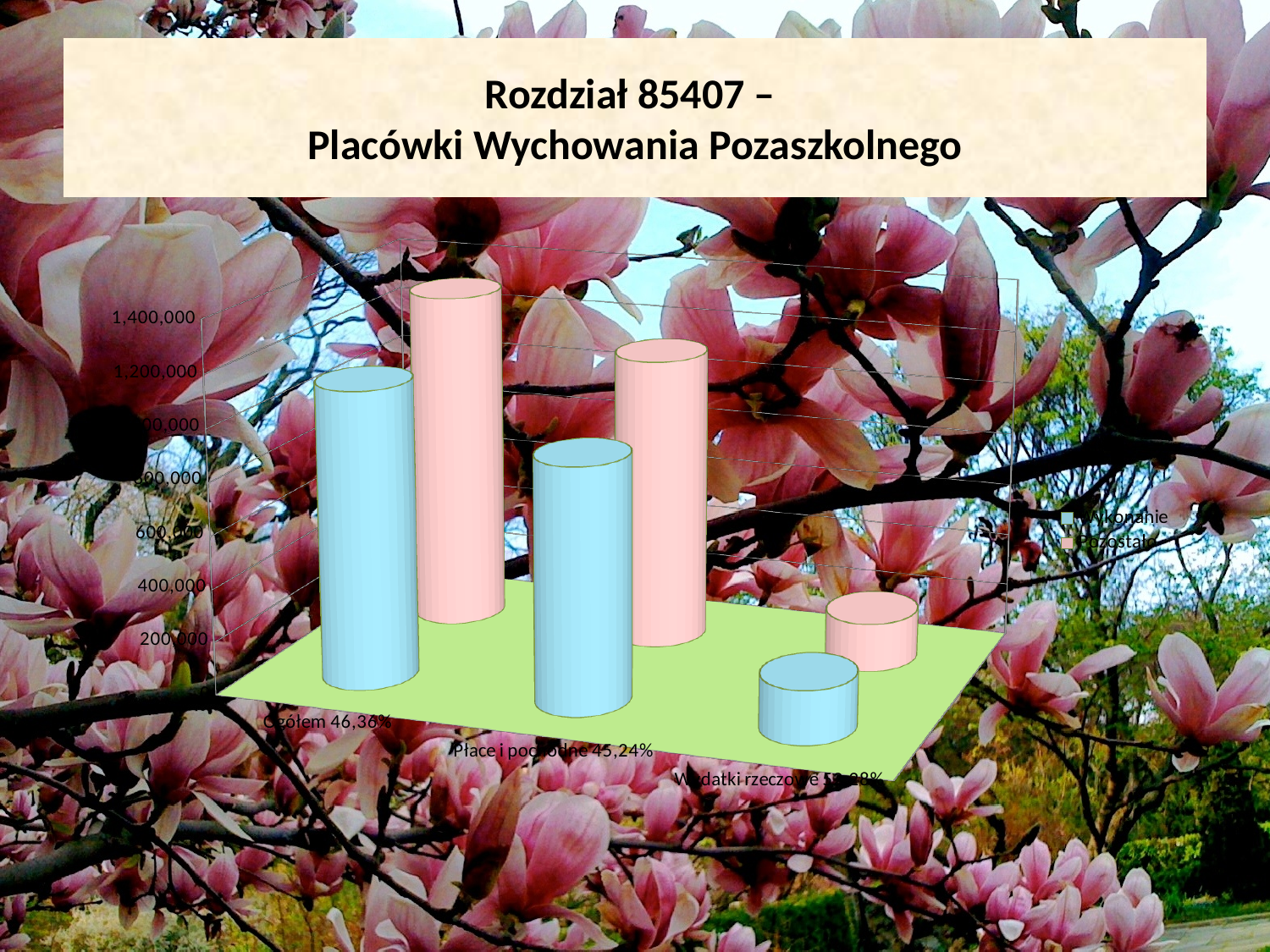
Do the Wykonanie values rise or fall from left to right across the categories? fall For Płace i pochodne, which series has the larger value, Wykonanie or Pozostało? Pozostało What percentage is shown in the category label for Ogółem? 46,36% How many categories are shown along the x axis of the chart? 3 Which category has the lowest values in the chart? Wydatki rzeczowe How many series does the chart legend list? 2 What kind of chart is shown on the slide? bar chart For Ogółem, which series has the larger value, Wykonanie or Pozostało? Pozostało What are the two series named in the chart legend? Wykonanie and Pozostało Which category has the tallest bar in the chart? Ogółem Is the Pozostało value for Ogółem greater or less than 1,000,000? greater Is the Wykonanie value for Płace i pochodne greater or less than 600,000? greater